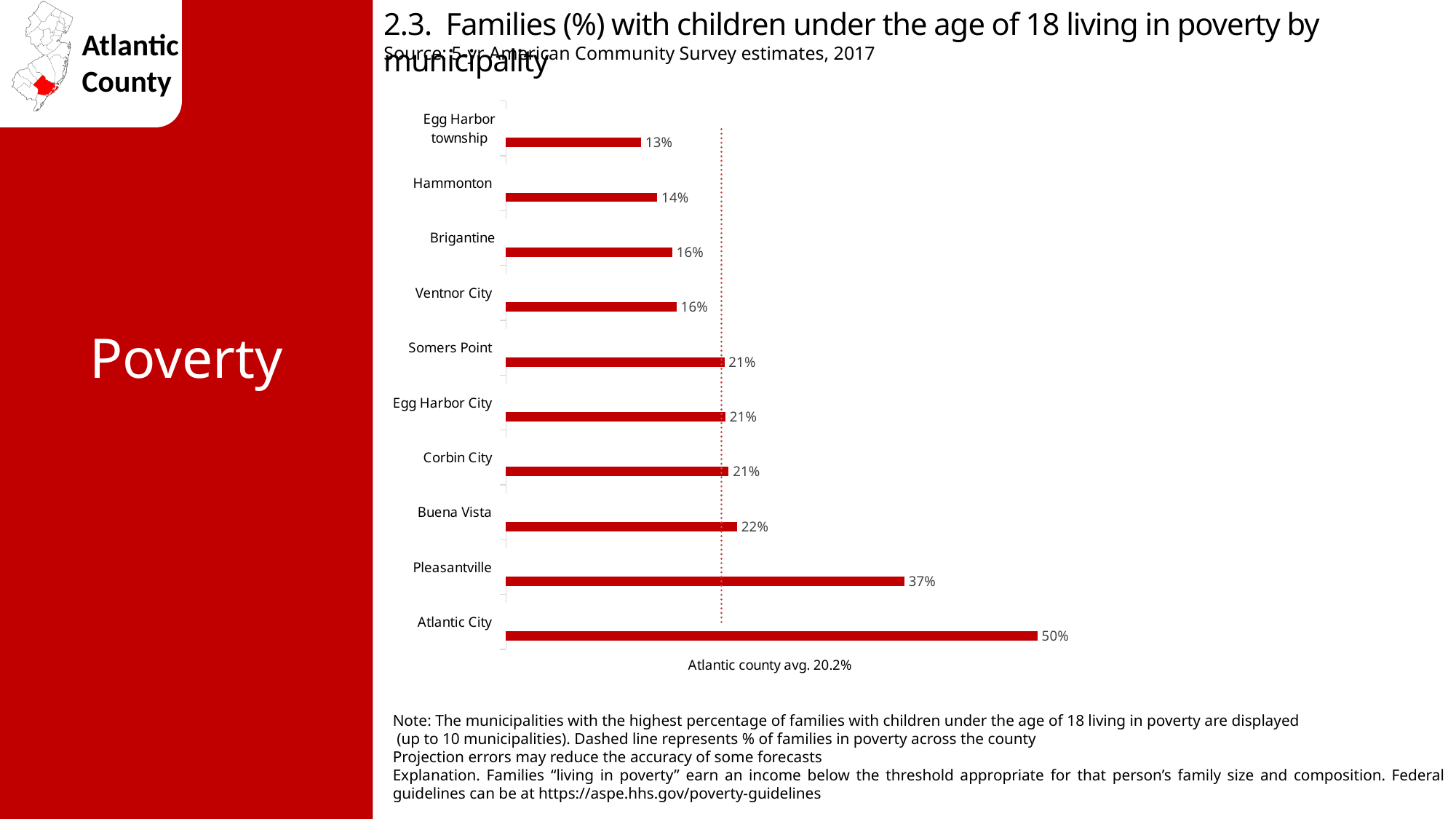
What kind of chart is shown on the slide? Bar chart What is the difference in percentage points between Buena Vista and Egg Harbor township? 9 How many municipalities are shown in the chart? 10 What is the value shown for Pleasantville? 37% What is the value shown for Egg Harbor township? 13% What Atlantic county average value is indicated by the dashed line? 20.2% Which has a higher value, Hammonton or Brigantine? Brigantine What is the value shown for Buena Vista? 22% Which municipality has the highest percentage of families with children living in poverty? Atlantic City What percentage of families with children under 18 live in poverty in Atlantic City? 50% Which municipality has the lowest percentage of families with children living in poverty? Egg Harbor township What is the difference in percentage points between Atlantic City and Pleasantville? 13